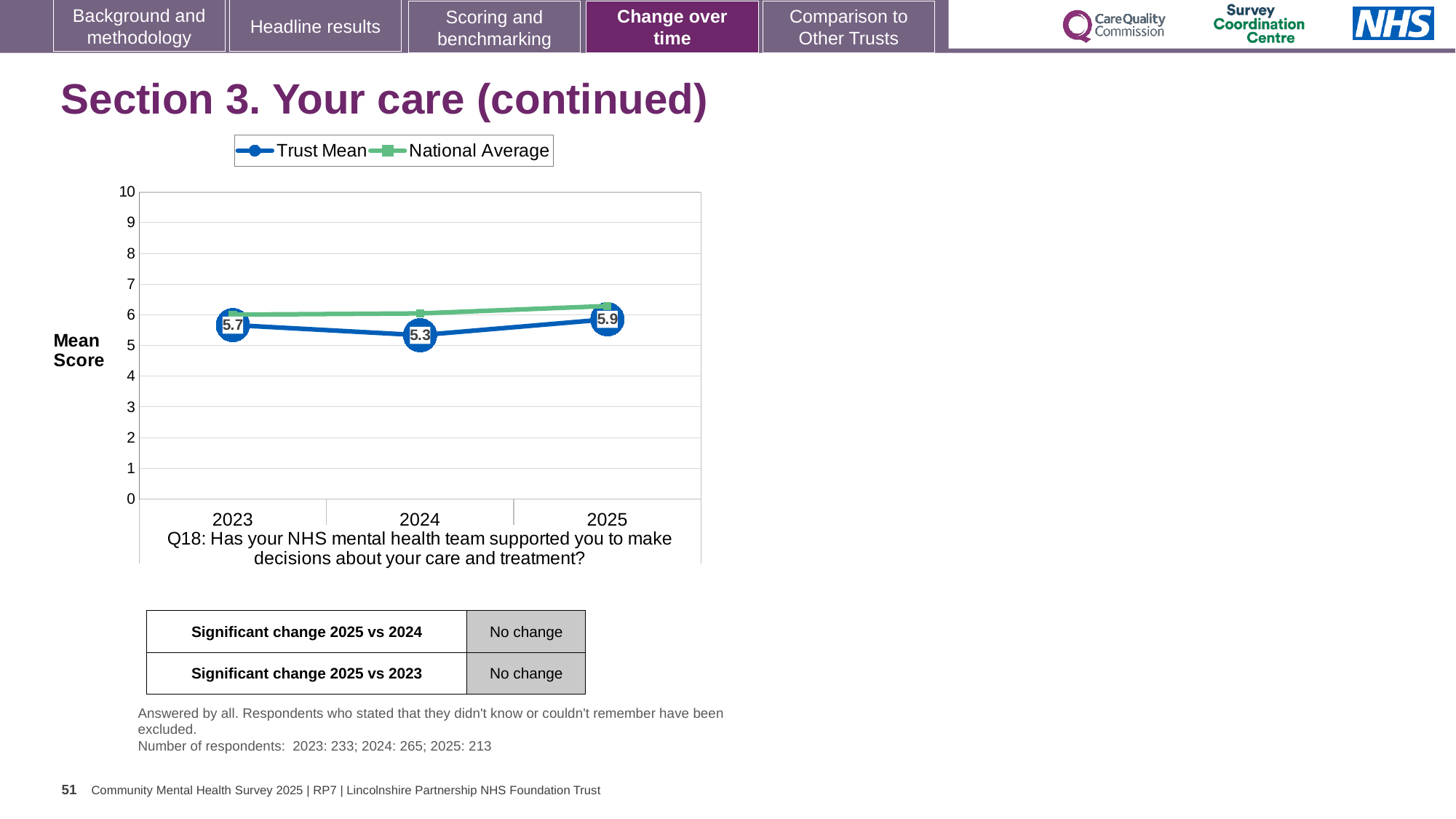
What is the Trust Mean value for 2024? 5.3 What is the Trust Mean value for 2023? 5.7 What is the label on the y axis of the chart? Mean Score Is the National Average value for 2025 greater or less than 5? greater How many series does the legend list? 2 Which is larger, the Trust Mean in 2023 or in 2024? 2023 In which year is the Trust Mean highest? 2025 What is the difference between the Trust Mean in 2025 and in 2024? 0.6 How many years are plotted on the x axis? 3 What kind of chart is shown on the slide? Line chart What is the Trust Mean value for 2025? 5.9 In which year is the Trust Mean lowest? 2024